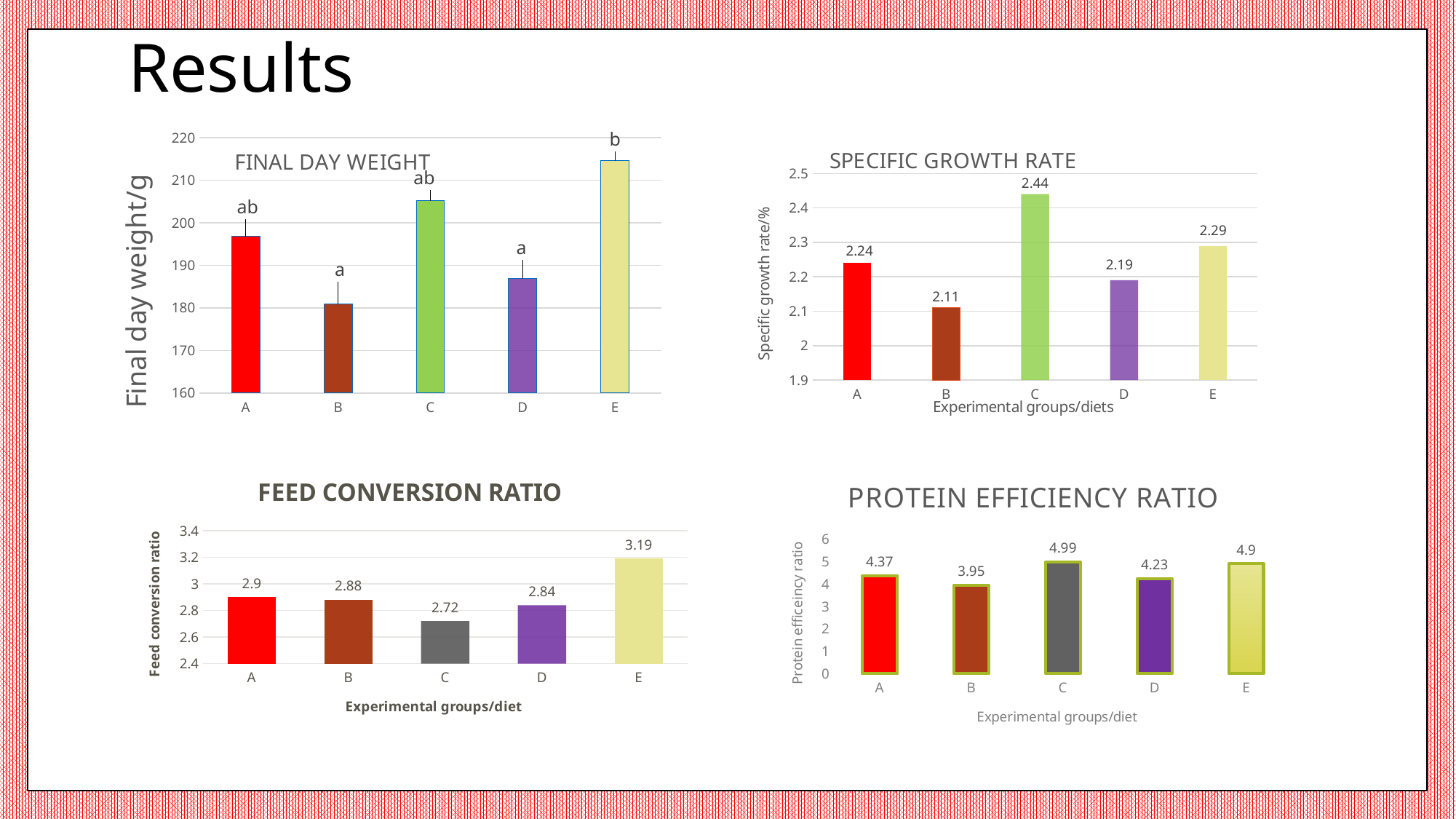
How many experimental groups are shown in the FINAL DAY WEIGHT chart? 5 In the PROTEIN EFFICIENCY RATIO chart, what is the difference between the values for group A and group D? 0.14 In the FINAL DAY WEIGHT chart, which group has the lowest final day weight? B In the FEED CONVERSION RATIO chart, which group has the lowest feed conversion ratio? C In the PROTEIN EFFICIENCY RATIO chart, what is the value for group B? 3.95 In the SPECIFIC GROWTH RATE chart, which group has the lowest specific growth rate? B In the SPECIFIC GROWTH RATE chart, what is the value for group C? 2.44 In the SPECIFIC GROWTH RATE chart, what is the difference between the values for group C and group B? 0.33 In the FEED CONVERSION RATIO chart, what is the value for group E? 3.19 In the PROTEIN EFFICIENCY RATIO chart, which group has the highest protein efficiency ratio? C In the FINAL DAY WEIGHT chart, is the value for group E greater or less than 210? greater In the FEED CONVERSION RATIO chart, which is larger, the value for group A or group D? A